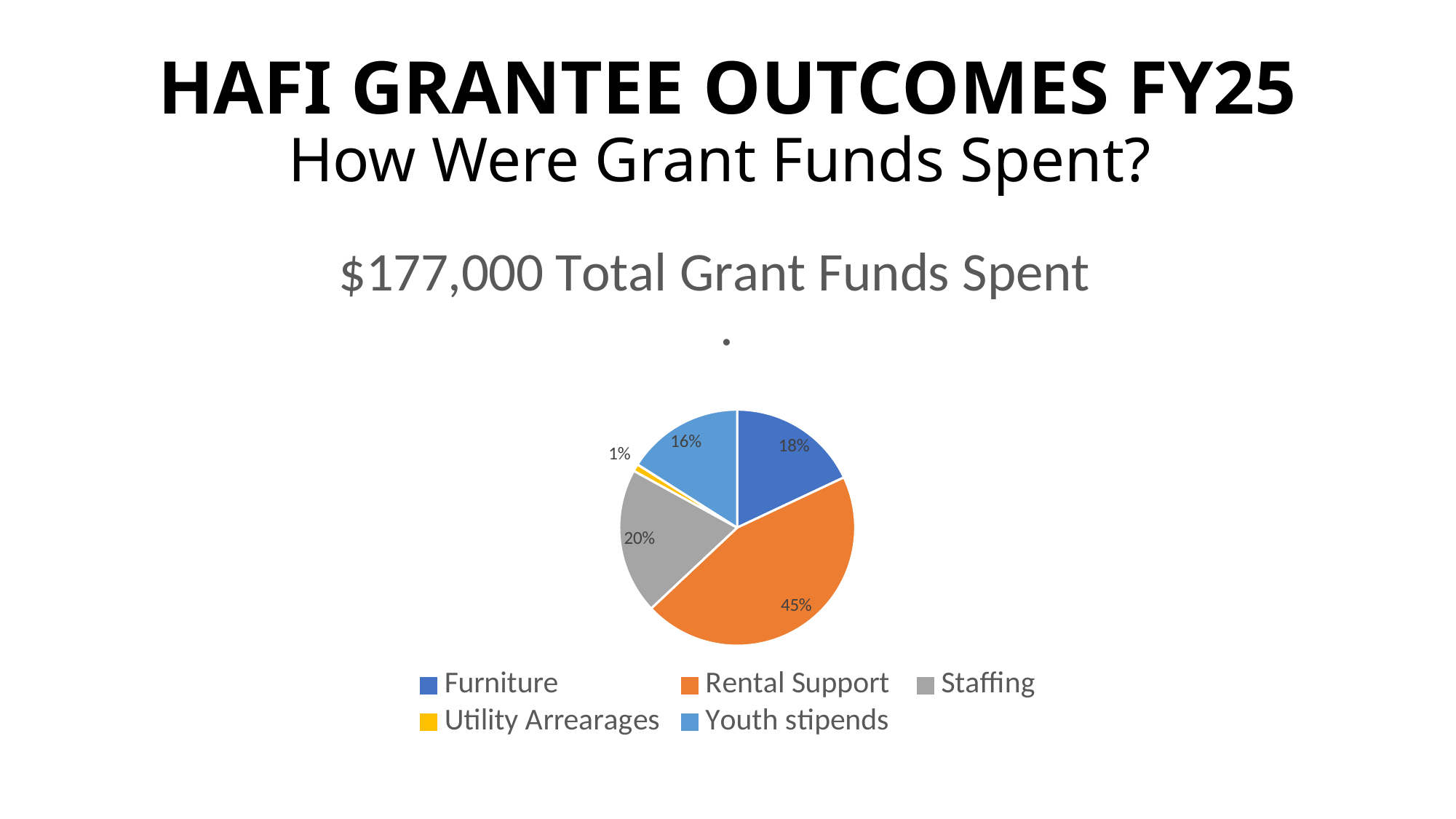
What share of grant funds was spent on Rental Support? 45% What share of grant funds was spent on Utility Arrearages? 1% What share of grant funds was spent on Staffing? 20% How many categories does the pie chart show? 5 What kind of chart is shown on the slide? pie chart Which category received the smallest share of grant funds? Utility Arrearages Which category received the largest share of grant funds? Rental Support Which is larger, the share for Furniture or the share for Youth stipends? Furniture What colour is the Staffing slice in the pie chart? gray What is the difference in percentage points between the Rental Support and Staffing shares? 25